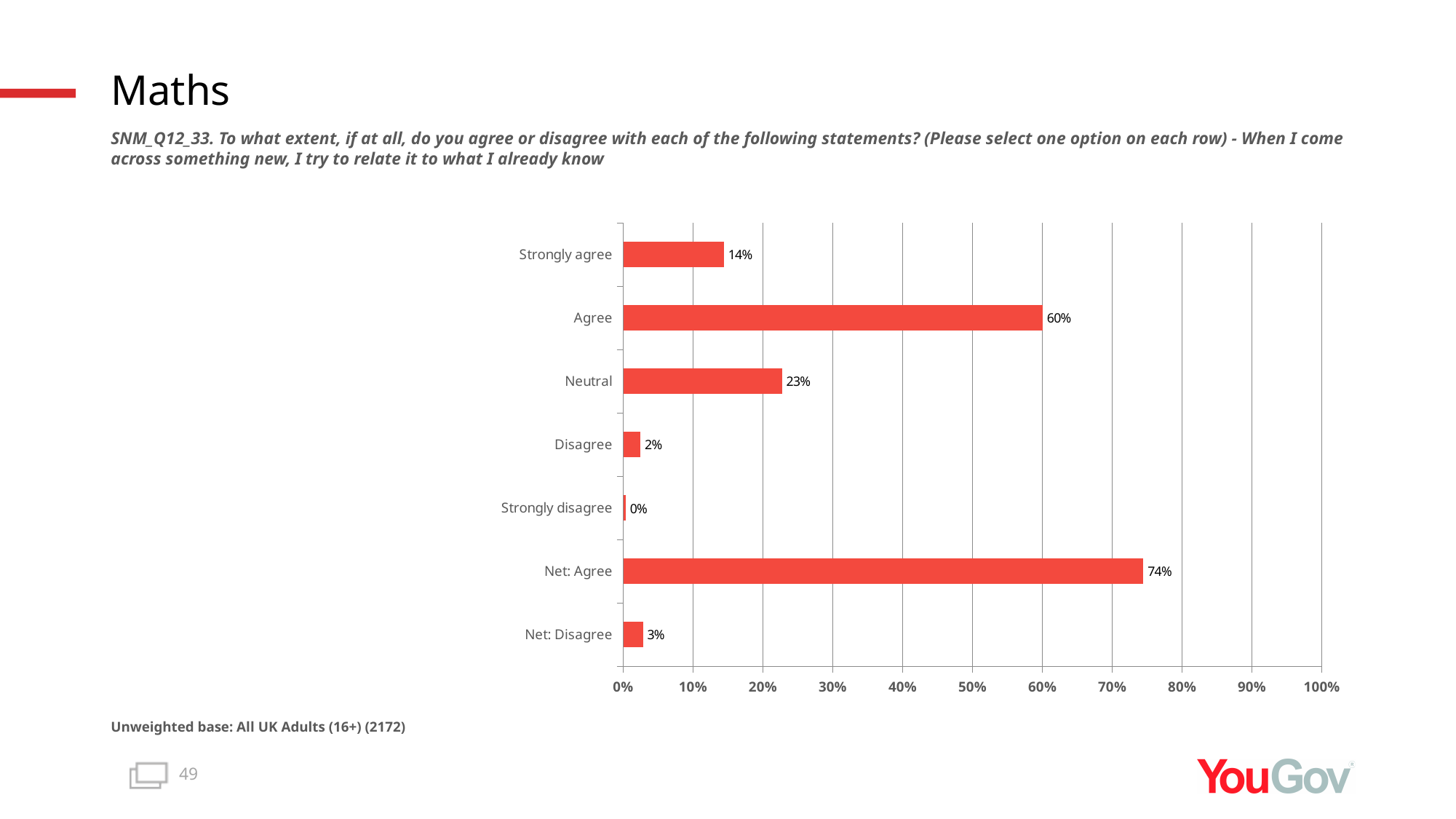
How many categories are shown on the chart? 7 Which category has the highest value? Net: Agree What is the value shown for "Strongly disagree"? 0% What is the difference between "Net: Agree" and "Net: Disagree"? 71% What is the difference between "Agree" and "Strongly agree"? 46% What kind of chart is shown on the slide? Bar chart Which category has the lowest value? Strongly disagree Which is larger, "Neutral" or "Strongly agree"? Neutral What is the value for "Net: Disagree"? 3% What is the value shown for "Neutral"? 23% Is the value for "Agree" greater or less than 50%? greater What percentage of respondents selected "Agree"? 60%